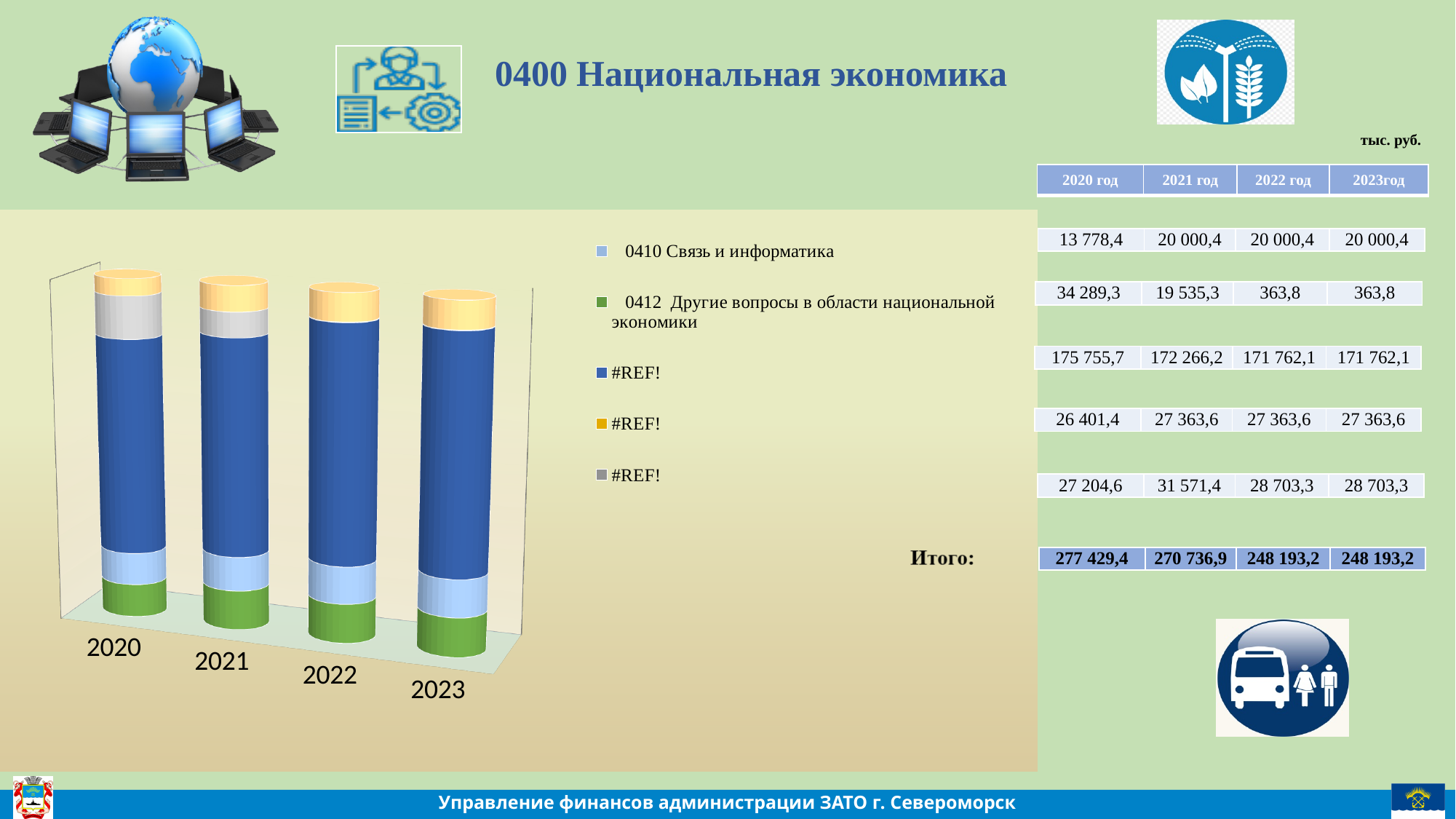
What kind of chart is shown on the slide? bar chart According to the Итого row, what is the difference between the totals for 2020 and 2021? 6 692,5 According to the Итого row, which year has the larger total, 2020 or 2022? 2020 Which colour in the legend represents "0410 Связь и информатика"? light blue How many years (categories) are plotted along the x axis of the chart? 4 Which years are shown on the x axis of the chart? 2020, 2021, 2022, 2023 How many legend entries in the chart are shown as "#REF!"? 3 How many series does the chart legend list? 5 According to the Итого row on the slide, what is the total for 2020? 277 429,4 According to the Итого row on the slide, what is the total for 2023? 248 193,2